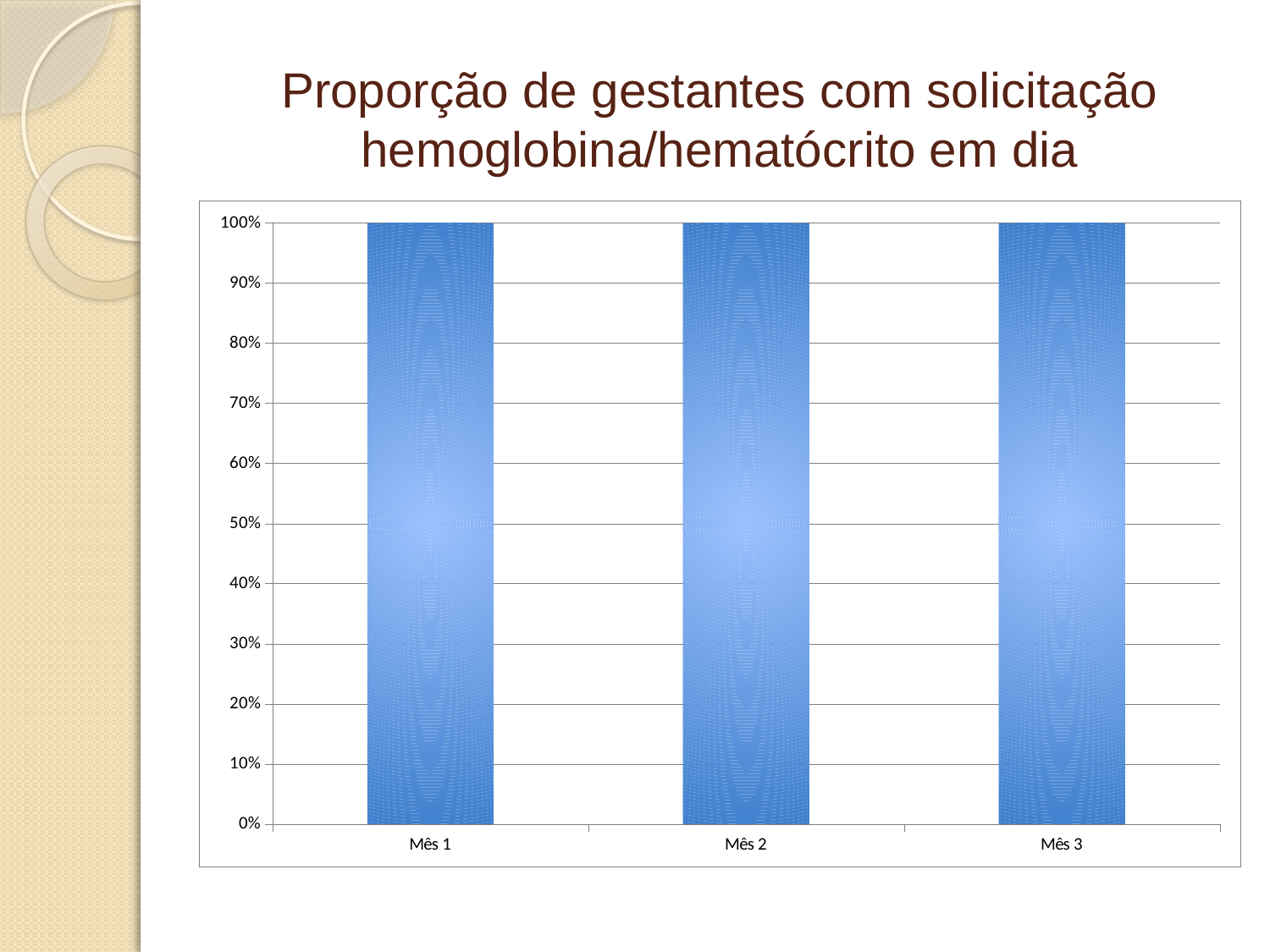
What kind of chart is shown on the slide? bar chart Is the value for Mês 2 greater or less than 50%? greater What is the difference between the values for Mês 1 and Mês 3? 0% What is the highest value shown on the y axis of the chart? 100% What is the value for Mês 3? 100% What is the value for Mês 1? 100% How many categories are shown on the x axis of the chart? 3 Is the value for Mês 3 greater or less than 90%? greater What is the title of the slide containing the chart? Proporção de gestantes com solicitação hemoglobina/hematócrito em dia